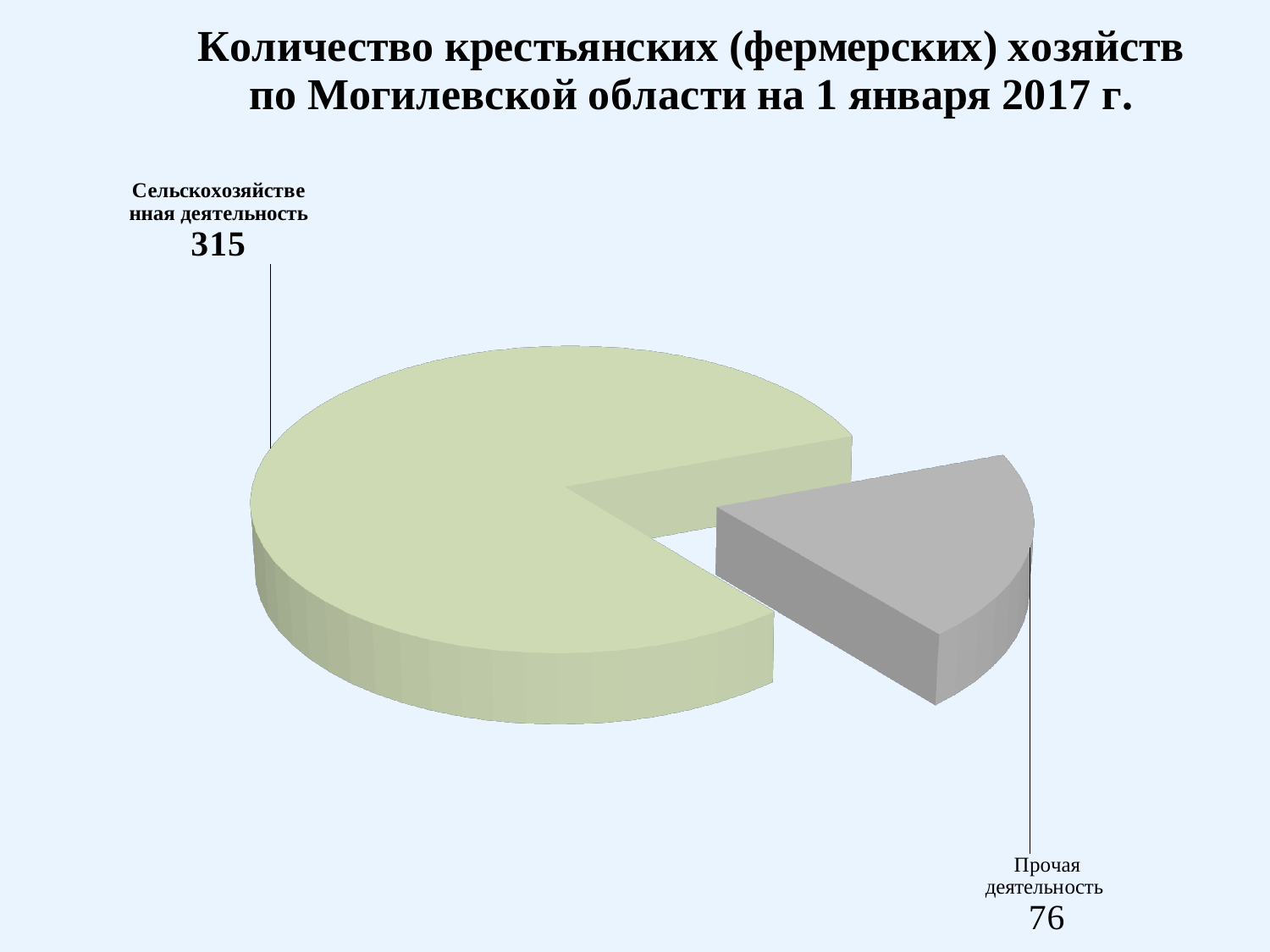
What share of the pie does Сельскохозяйственная деятельность represent, to the nearest whole percent? 81% Which is larger: the value for Сельскохозяйственная деятельность or the value for Прочая деятельность? Сельскохозяйственная деятельность What share of the pie does Прочая деятельность represent, to the nearest whole percent? 19% What is the difference between the values for Сельскохозяйственная деятельность and Прочая деятельность? 239 What is the value for Сельскохозяйственная деятельность? 315 Which category has the smallest slice of the pie? Прочая деятельность How many categories (slices) does the pie chart show? 2 What is the total of all slices in the pie chart? 391 What is the title of the chart on the slide? Количество крестьянских (фермерских) хозяйств по Могилевской области на 1 января 2017 г. Which category has the largest slice of the pie? Сельскохозяйственная деятельность What is the value for Прочая деятельность? 76 What kind of chart is shown on the slide? Pie chart